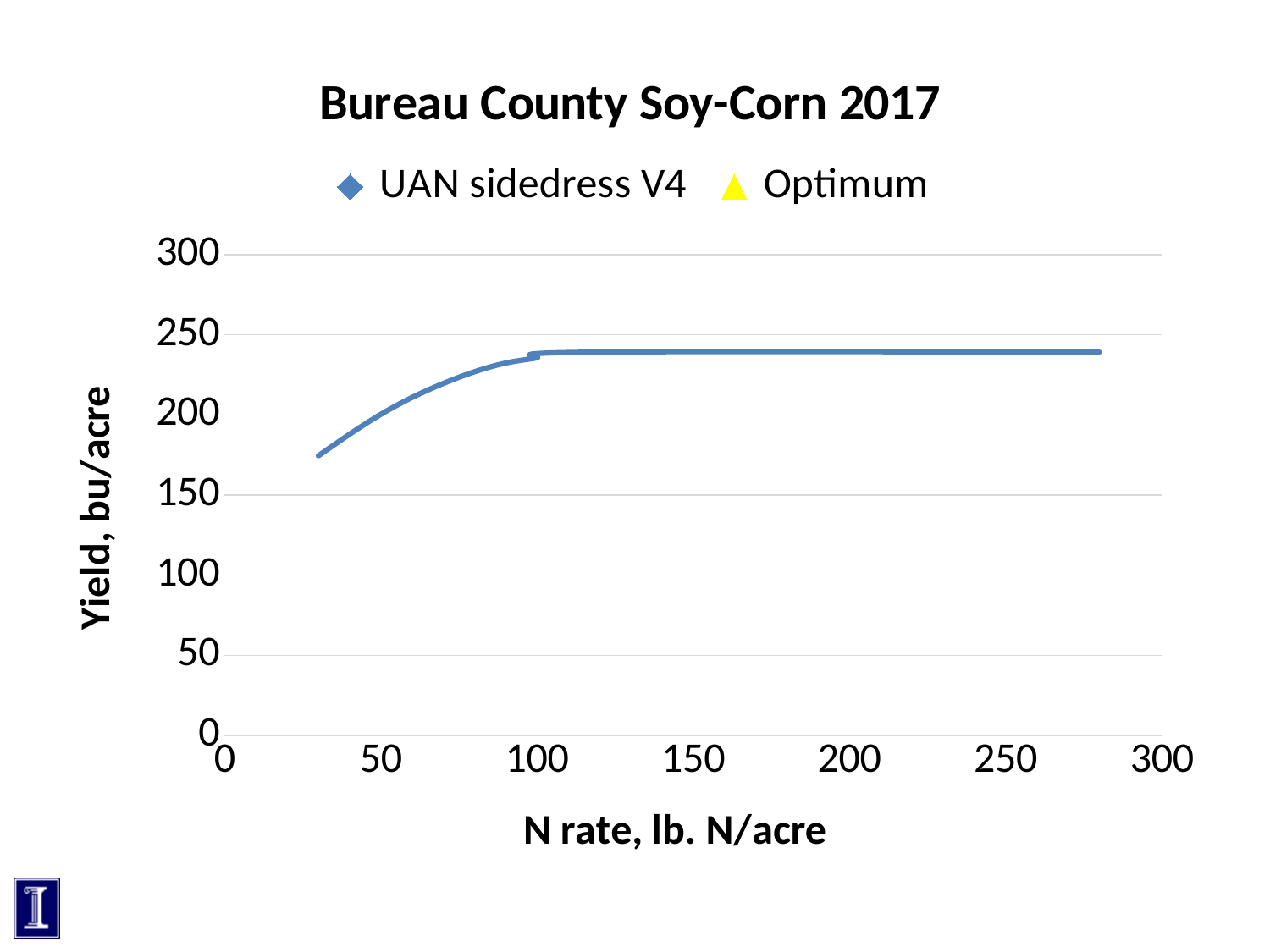
Does the yield for UAN sidedress V4 rise or fall as the N rate increases from about 30 to 100 lb. N/acre? rise Which is larger for UAN sidedress V4: the yield at an N rate of 50 or the yield at an N rate of 150 lb. N/acre? 150 Is the yield for UAN sidedress V4 at the lowest plotted N rate (about 30 lb. N/acre) greater or less than 200? less What is the highest value shown on the y axis? 300 What kind of chart is shown on the slide? line chart Is the yield for UAN sidedress V4 at an N rate of 100 lb. N/acre greater or less than 200? greater What is the label of the y axis? Yield, bu/acre How many series does the chart legend list? 2 Is the yield for UAN sidedress V4 at the lowest plotted N rate (about 30 lb. N/acre) greater or less than 150? greater What is the title of the chart? Bureau County Soy-Corn 2017